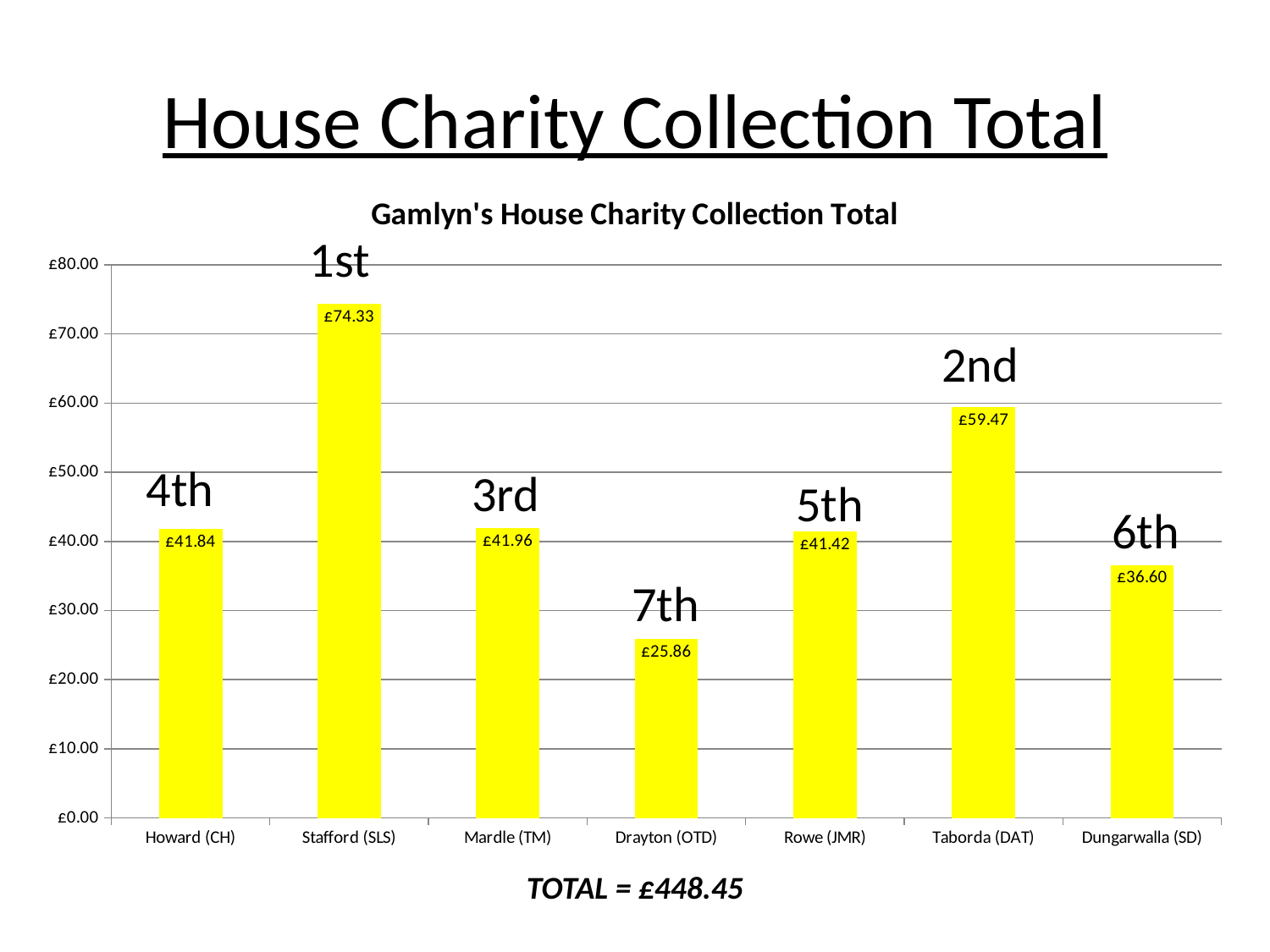
Which house has the highest collection total? Stafford (SLS) Which house has the lowest collection total? Drayton (OTD) What is the title of the chart? Gamlyn's House Charity Collection Total How many houses are shown on the chart? 7 What is the value for Stafford (SLS)? £74.33 What kind of chart is shown on the slide? Bar chart What is the value for Dungarwalla (SD)? £36.60 Which is larger, the value for Taborda (DAT) or the value for Dungarwalla (SD)? Taborda (DAT) Is the value for Howard (CH) greater or less than £50.00? less What is the value for Drayton (OTD)? £25.86 What is the difference between the values for Stafford (SLS) and Taborda (DAT)? £14.86 What is the value for Taborda (DAT)? £59.47